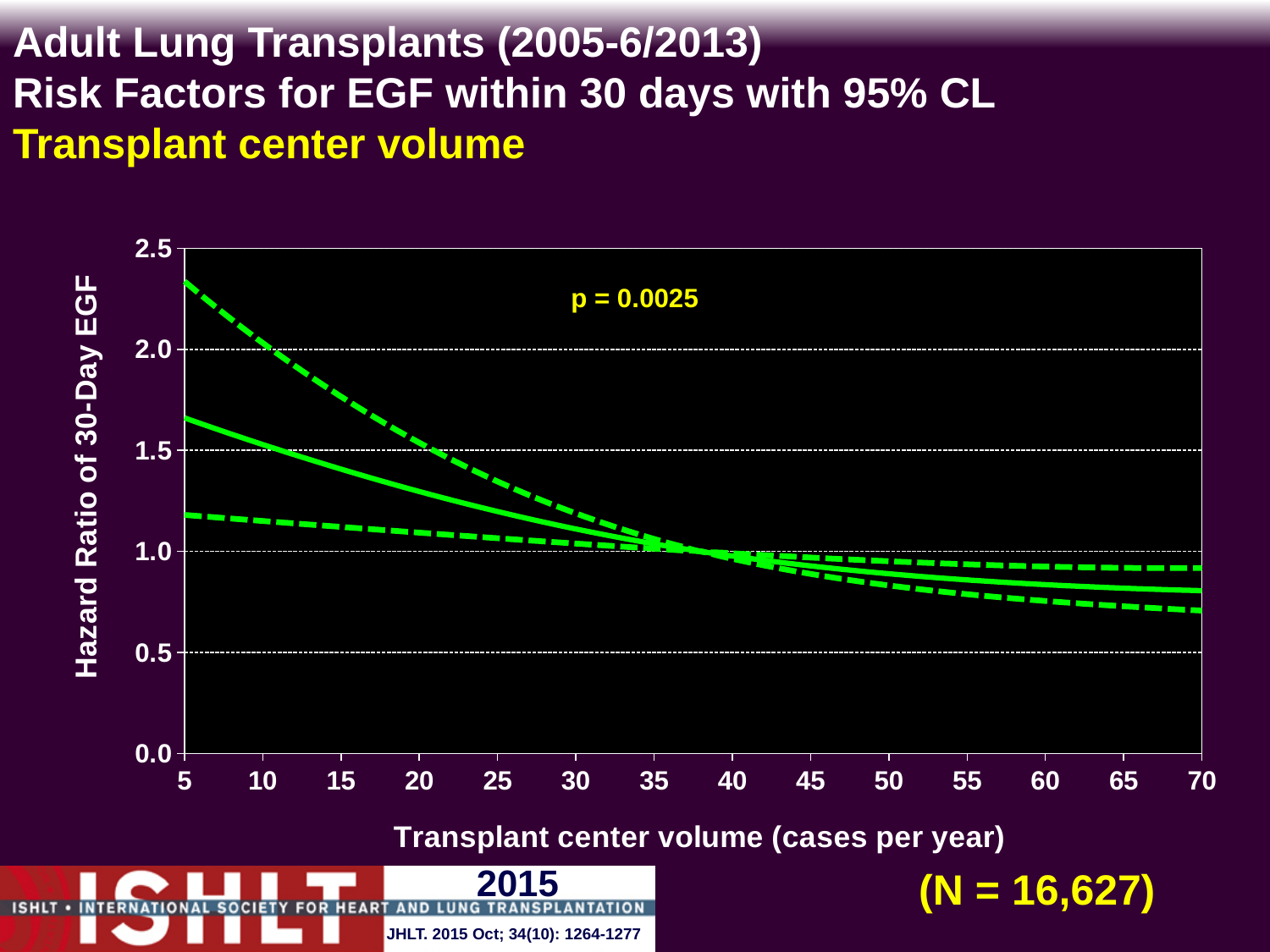
Is the lower 95% confidence limit (lower dashed line) at a transplant center volume of 70 cases per year greater or less than 0.5? greater What p-value is printed on the chart? p = 0.0025 What is the highest value shown on the x-axis? 70 Does the hazard ratio of 30-day EGF (solid line) rise or fall as transplant center volume increases? fall Is the hazard ratio (solid line) at a transplant center volume of 20 cases per year greater or less than 1.0? greater What kind of chart is shown on the slide? line chart What is the label of the y-axis? Hazard Ratio of 30-Day EGF Is the hazard ratio (solid line) at a transplant center volume of 70 cases per year greater or less than 1.0? less How many lines are plotted on the chart? 3 What is the lowest value shown on the x-axis? 5